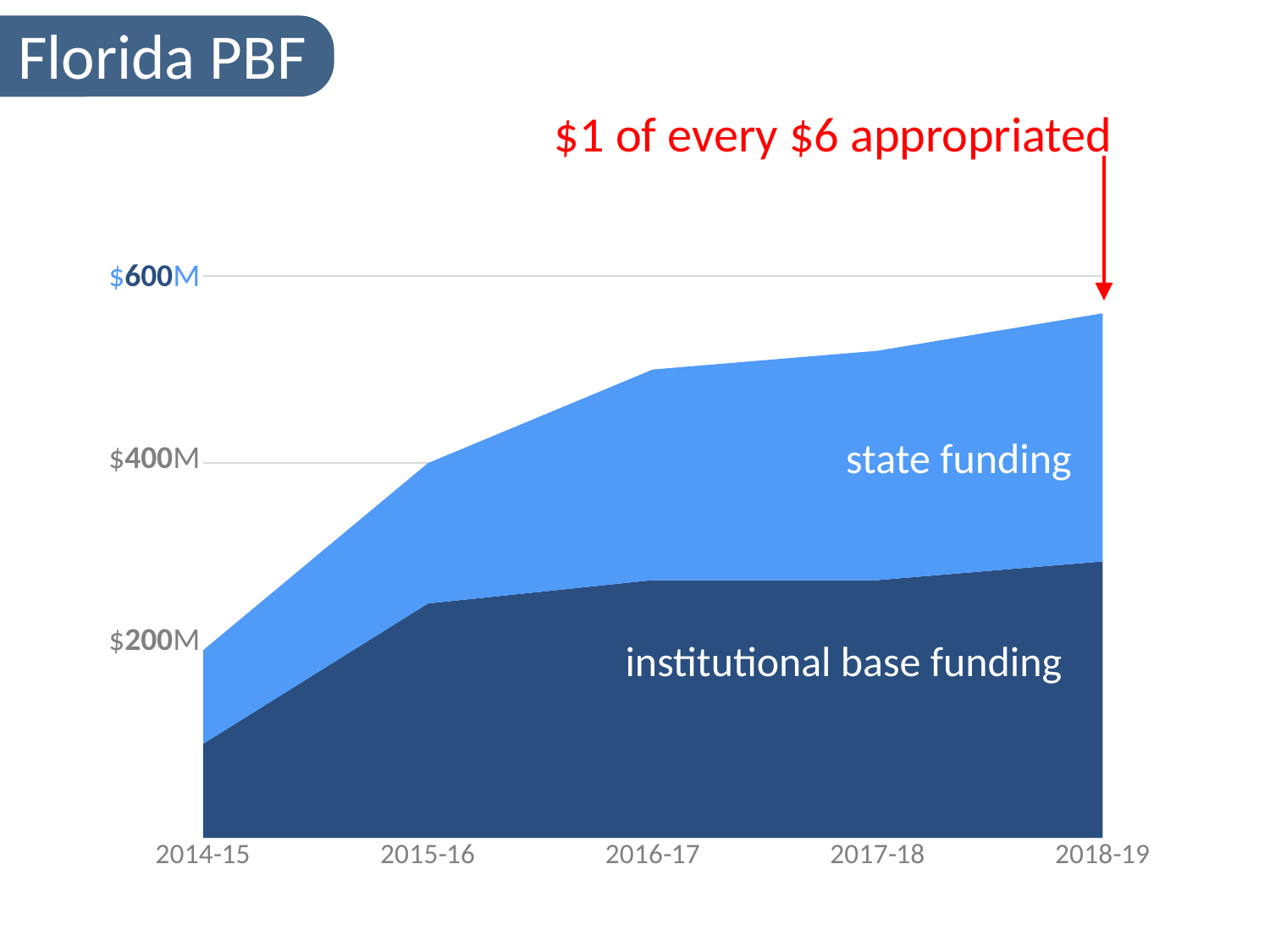
In which year is total funding highest? 2018-19 What does the red annotation above the chart say? $1 of every $6 appropriated Is the total funding for 2018-19 greater or less than $600M? less What kind of chart is shown on the slide? Stacked area chart How many series are plotted in the chart? 2 In which year is total funding lowest? 2014-15 Is institutional base funding in 2018-19 greater or less than $200M? greater How many fiscal years are shown along the x axis? 5 Which two series are labelled in the chart? state funding and institutional base funding Is the total funding for 2016-17 greater or less than $400M? greater Does total funding rise or fall from 2014-15 to 2018-19? Rise